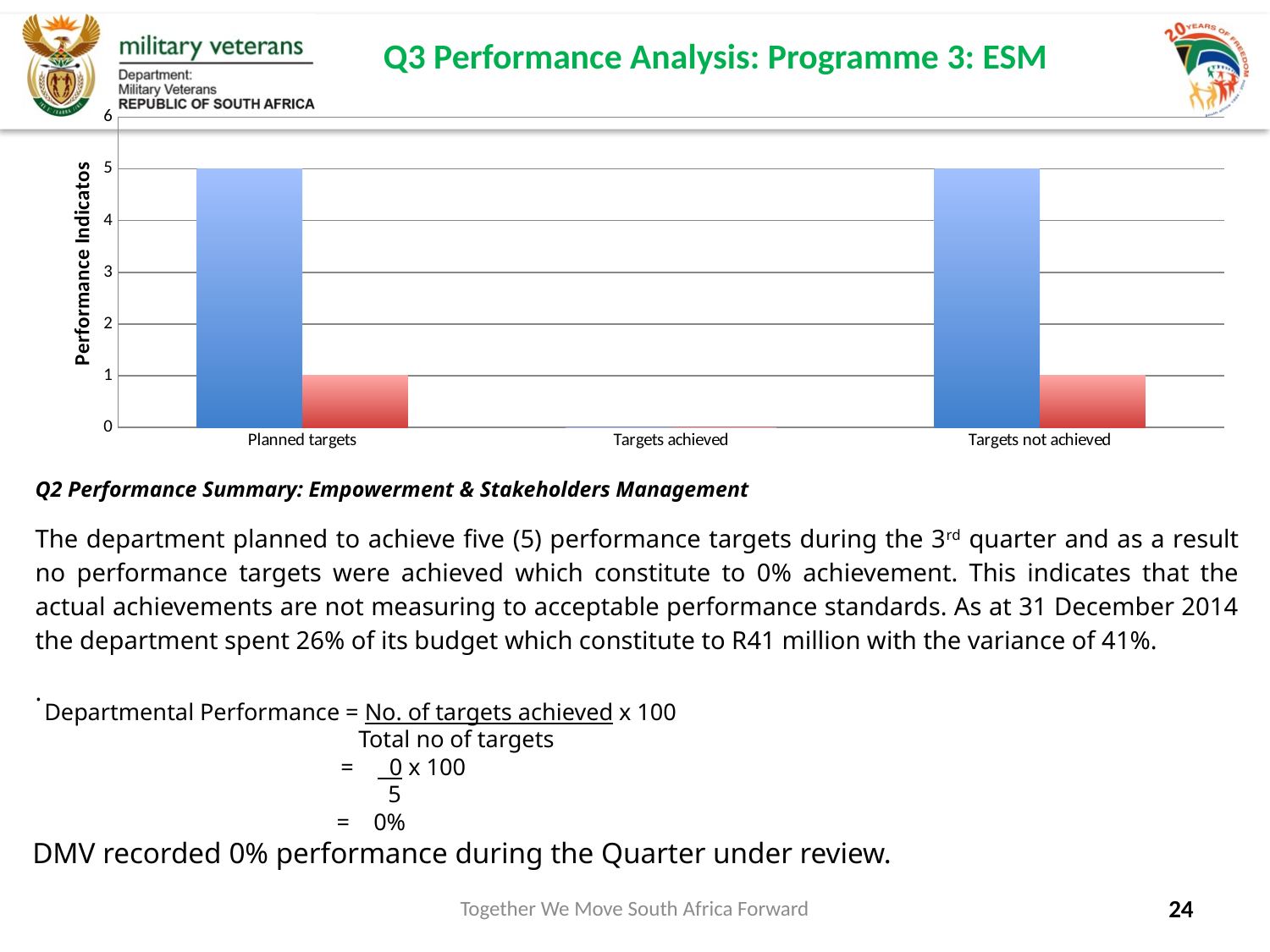
What is the label on the y axis of the chart? Performance Indicatos What is the difference between the blue bar and the red bar for Targets not achieved? 4 How many categories are shown on the x axis of the chart? 3 What is the value of the blue bar for Targets not achieved? 5 Is the value of the blue bar for Planned targets greater or less than 3? greater What is the value of the blue bar for Planned targets? 5 Which category has no bars plotted at all? Targets achieved What is the value shown for Targets achieved? 0 What kind of chart is shown on the slide? Bar chart What is the value of the red bar for Planned targets? 1 What is the value of the red bar for Targets not achieved? 1 For Planned targets, which bar is larger, the blue bar or the red bar? Blue bar